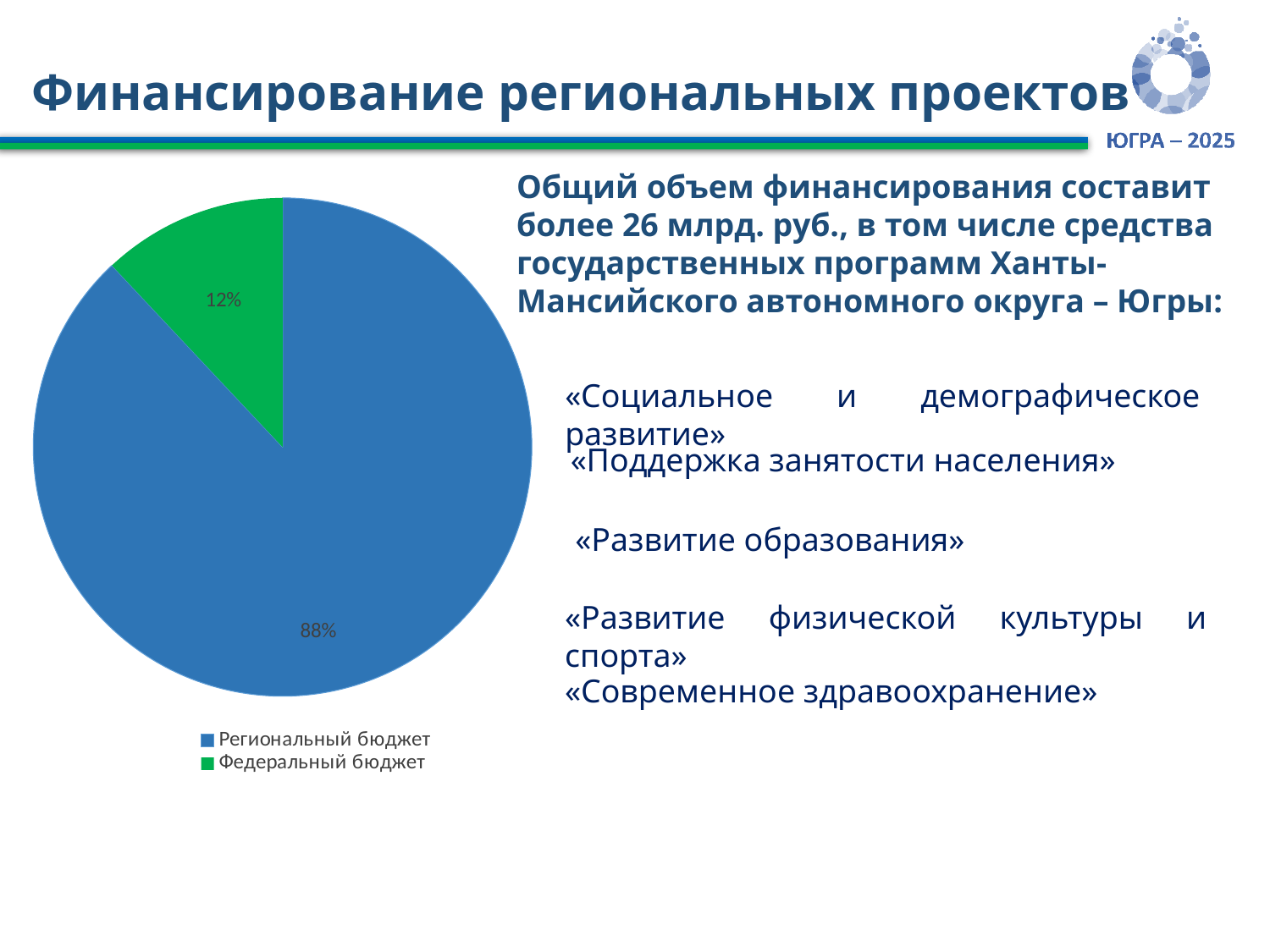
Which is larger: Региональный бюджет or Федеральный бюджет? Региональный бюджет What colour is the Федеральный бюджет slice? green Which slice of the pie is the smallest? Федеральный бюджет How many entries does the legend list? 2 What type of chart is shown on the slide? pie chart What is the difference in percentage points between Региональный бюджет and Федеральный бюджет? 76 Which slice of the pie is the largest? Региональный бюджет What share of the pie does Федеральный бюджет have? 12% How many slices does the pie chart have? 2 What share of the pie does Региональный бюджет have? 88% What colour is the Региональный бюджет slice? blue